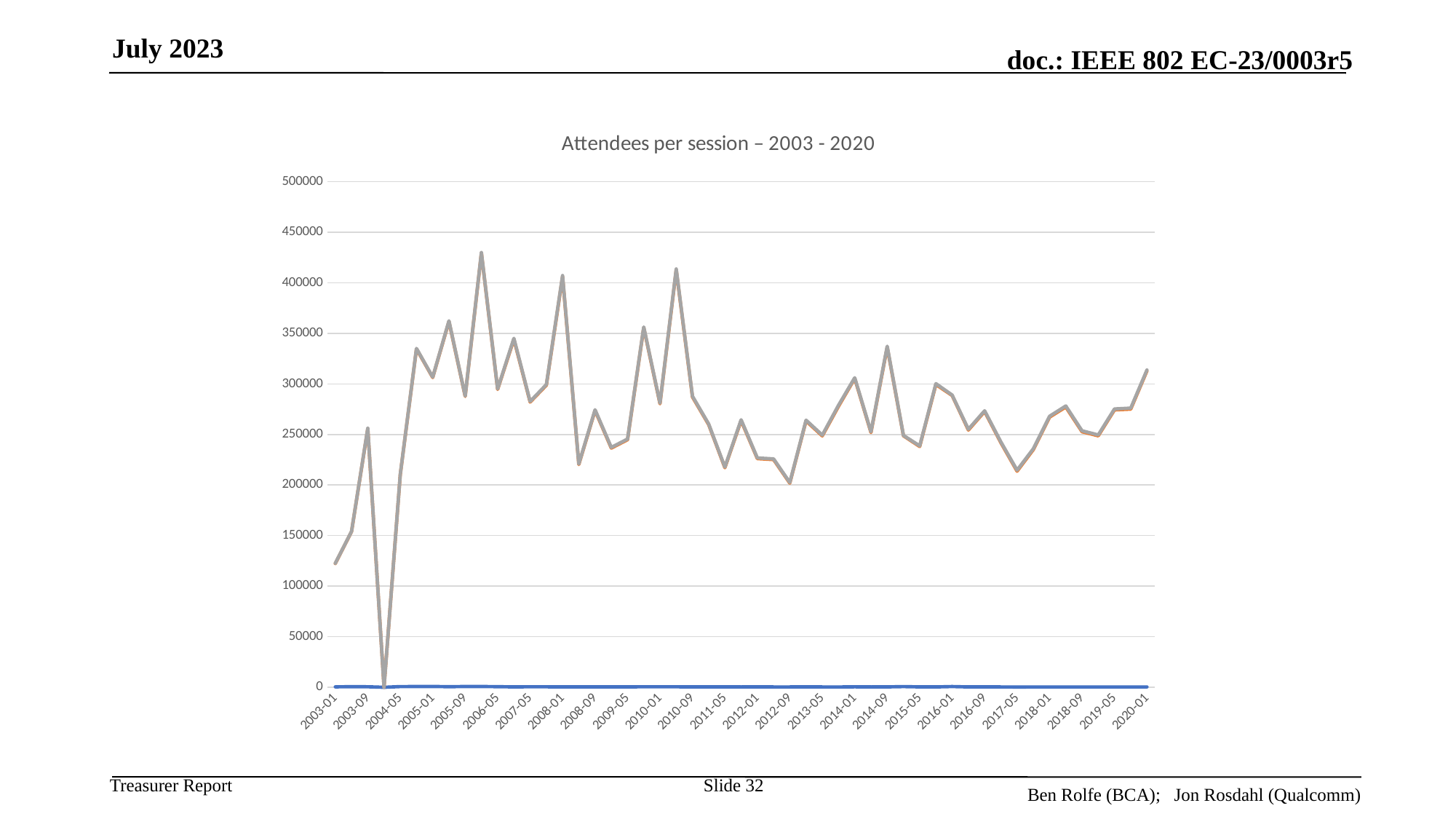
Is the value for 2012-09 greater or less than 250000? less Which has the larger value, 2003-01 or 2020-01? 2020-01 Is the value for 2005-01 greater or less than 300000? greater Is the value for 2010-09 greater or less than 350000? less Do the values rise or fall from 2017-05 to 2020-01? rise What kind of chart is shown on the slide? line chart What is the title of the chart? Attendees per session – 2003 - 2020 Which has the larger value, 2008-01 or 2008-09? 2008-01